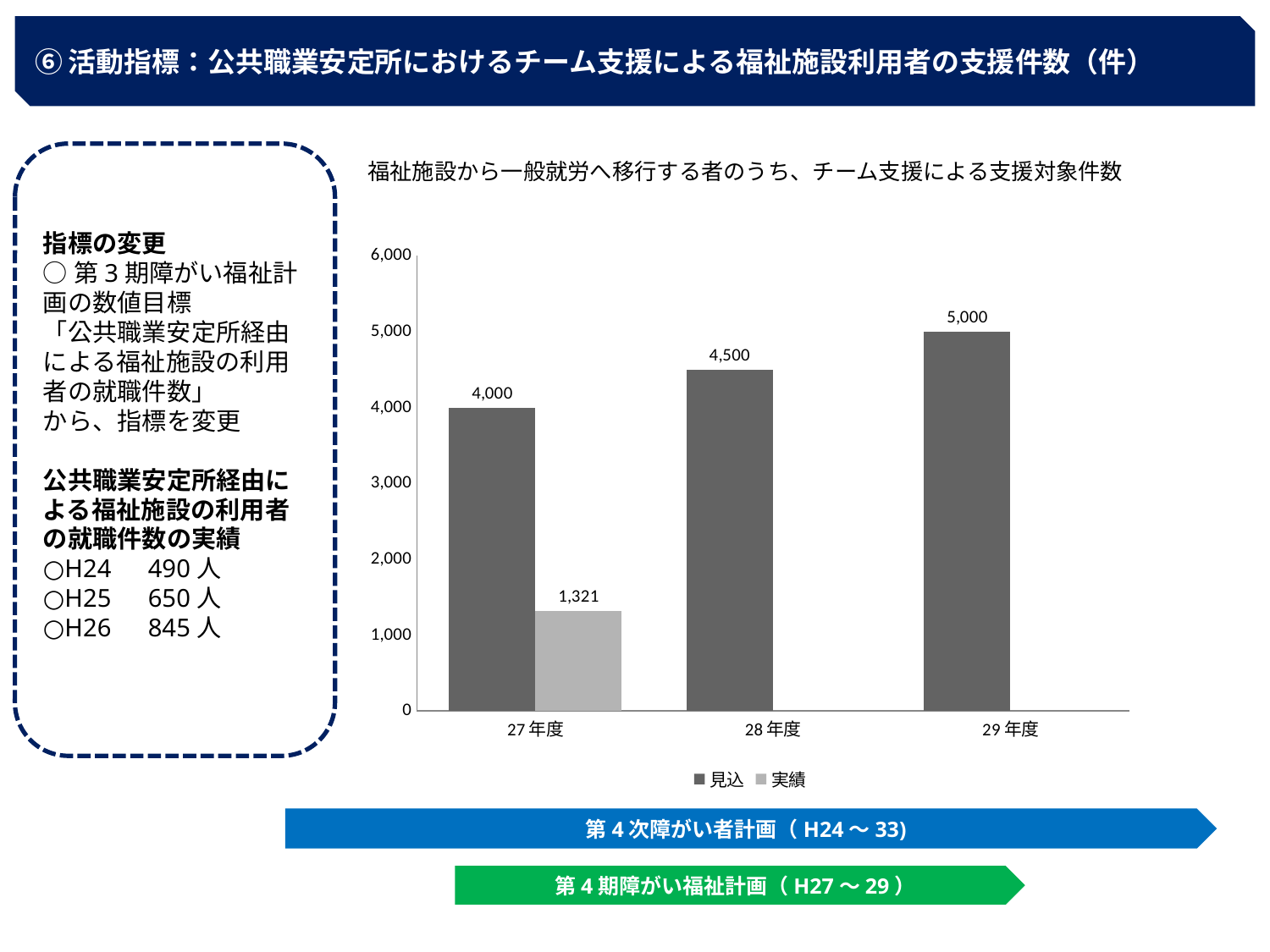
What is the 見込 value for 28年度? 4,500 What is the 見込 value for 27年度? 4,000 Do the 見込 values rise or fall from 27年度 to 29年度? Rise What is the 実績 value for 27年度? 1,321 What is the difference between the 見込 values for 29年度 and 27年度? 1,000 What kind of chart is shown? Bar chart What is the difference between the 見込 and 実績 values for 27年度? 2,679 Which year has the lowest 見込 value? 27年度 How many series does the legend list? 2 What is the 見込 value for 29年度? 5,000 Which is larger, the 見込 value for 28年度 or the 実績 value for 27年度? 見込 for 28年度 Which year has the highest 見込 value? 29年度